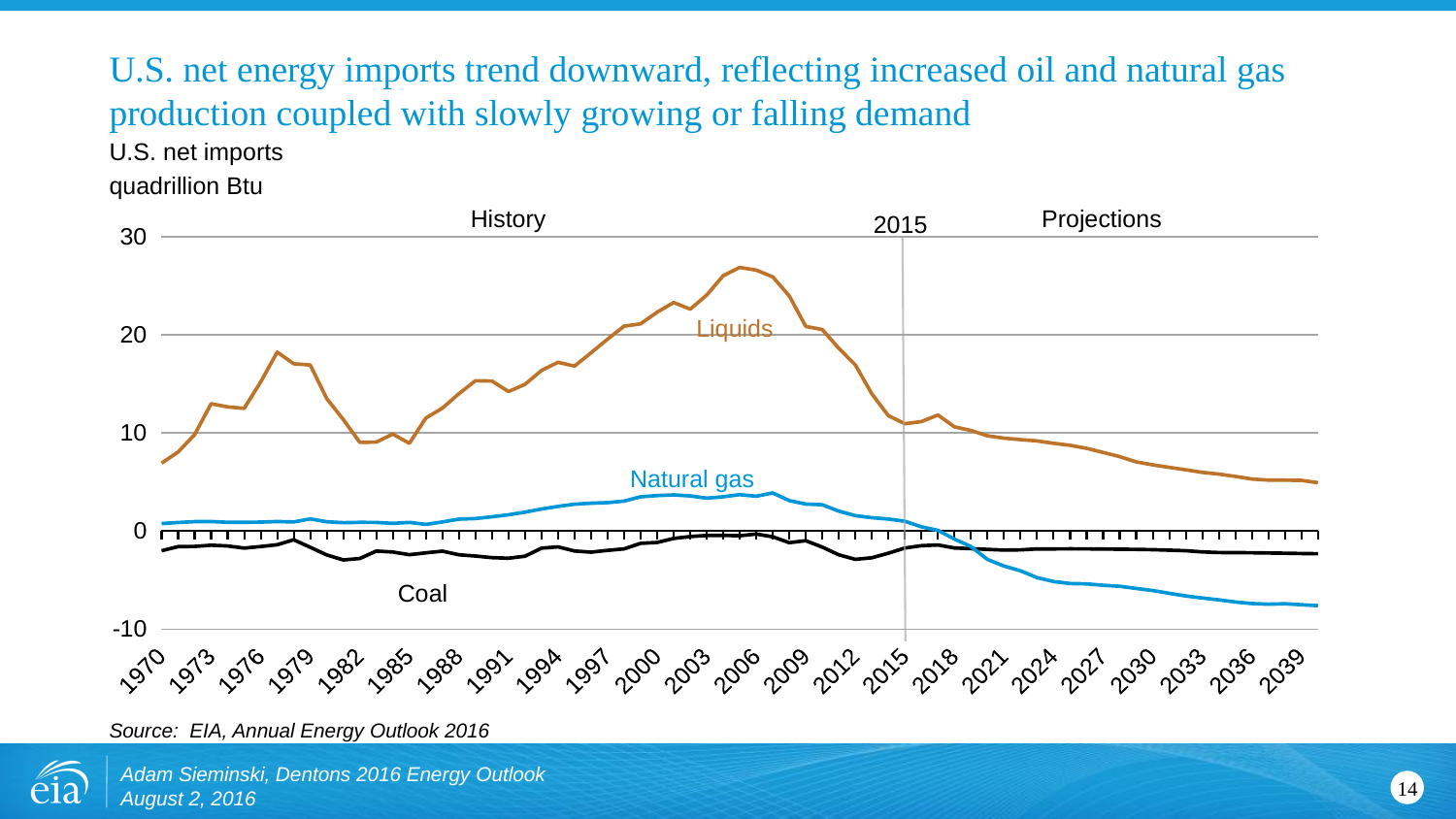
How many series are plotted on the chart? 3 Is the value for Natural gas in 2039 greater or less than 0? less Which series has the lowest value in 2039? Natural gas What unit is the y axis measured in? quadrillion Btu Which series has the highest value in 2006? Liquids Is the value for Liquids in 2039 greater or less than 10? less What year marks the boundary between History and Projections on the chart? 2015 Is the value for Liquids in 1970 greater or less than 10? less What kind of chart is shown on the slide? line chart Do the values for Liquids rise or fall from 2015 to 2039? fall Which is larger in 2015, the value for Liquids or the value for Natural gas? Liquids